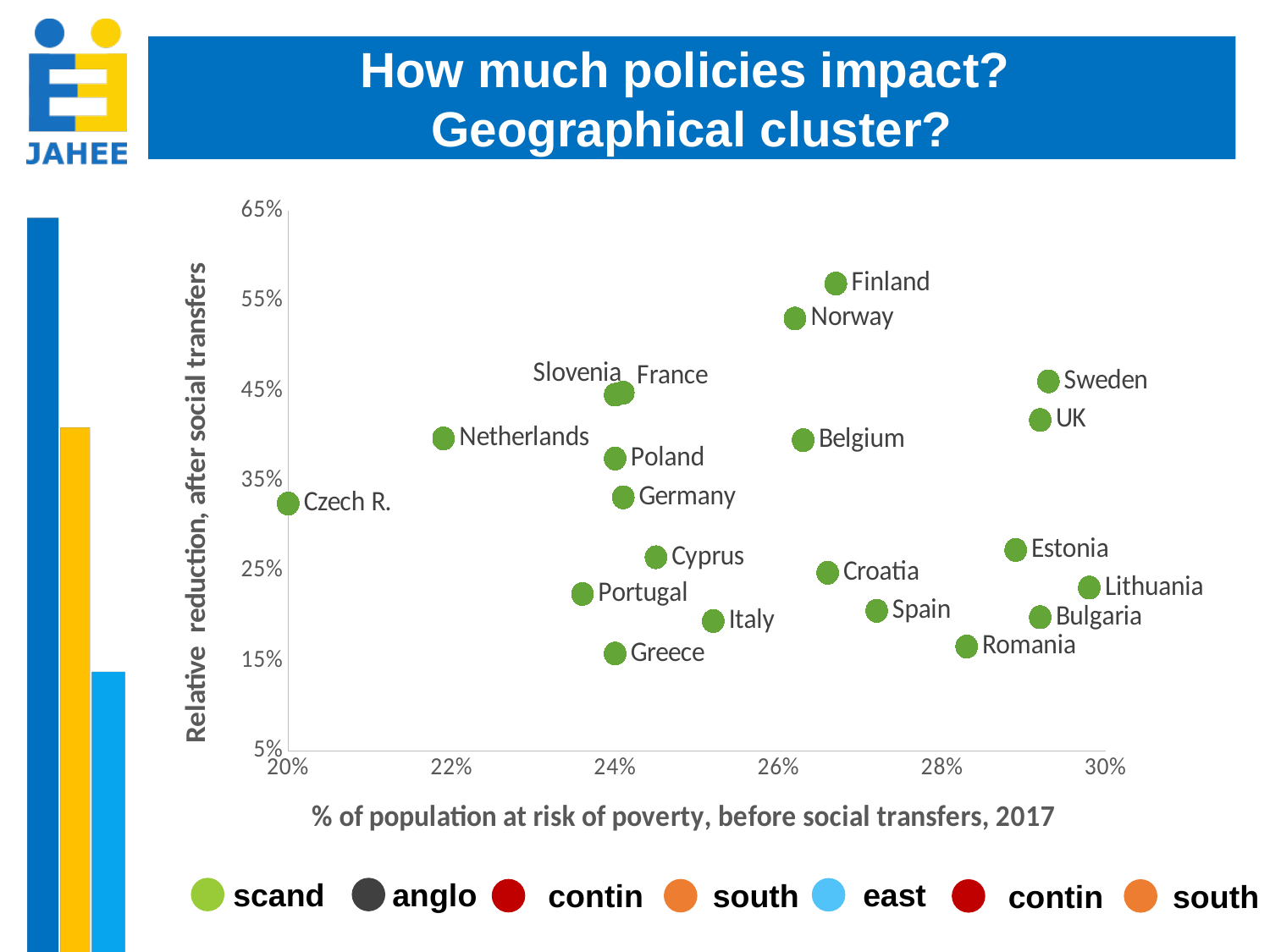
Is the relative reduction for Czech R. greater or less than 35%? less Which country has the highest % of population at risk of poverty before social transfers (furthest right on the x axis)? Lithuania What kind of chart is shown on the slide? Scatter chart Which has a higher relative reduction after social transfers, Finland or Norway? Finland What is the title of the x axis? % of population at risk of poverty, before social transfers, 2017 Which country has the lowest relative reduction after social transfers? Greece How many countries are labelled on the chart? 21 Is the % of population at risk of poverty before social transfers for Romania greater or less than 28%? greater Which has a higher relative reduction after social transfers, Poland or Germany? Poland Is the relative reduction for Finland greater or less than 55%? greater Which country has the lowest % of population at risk of poverty before social transfers (furthest left on the x axis)? Czech R. Which country has the highest relative reduction after social transfers? Finland